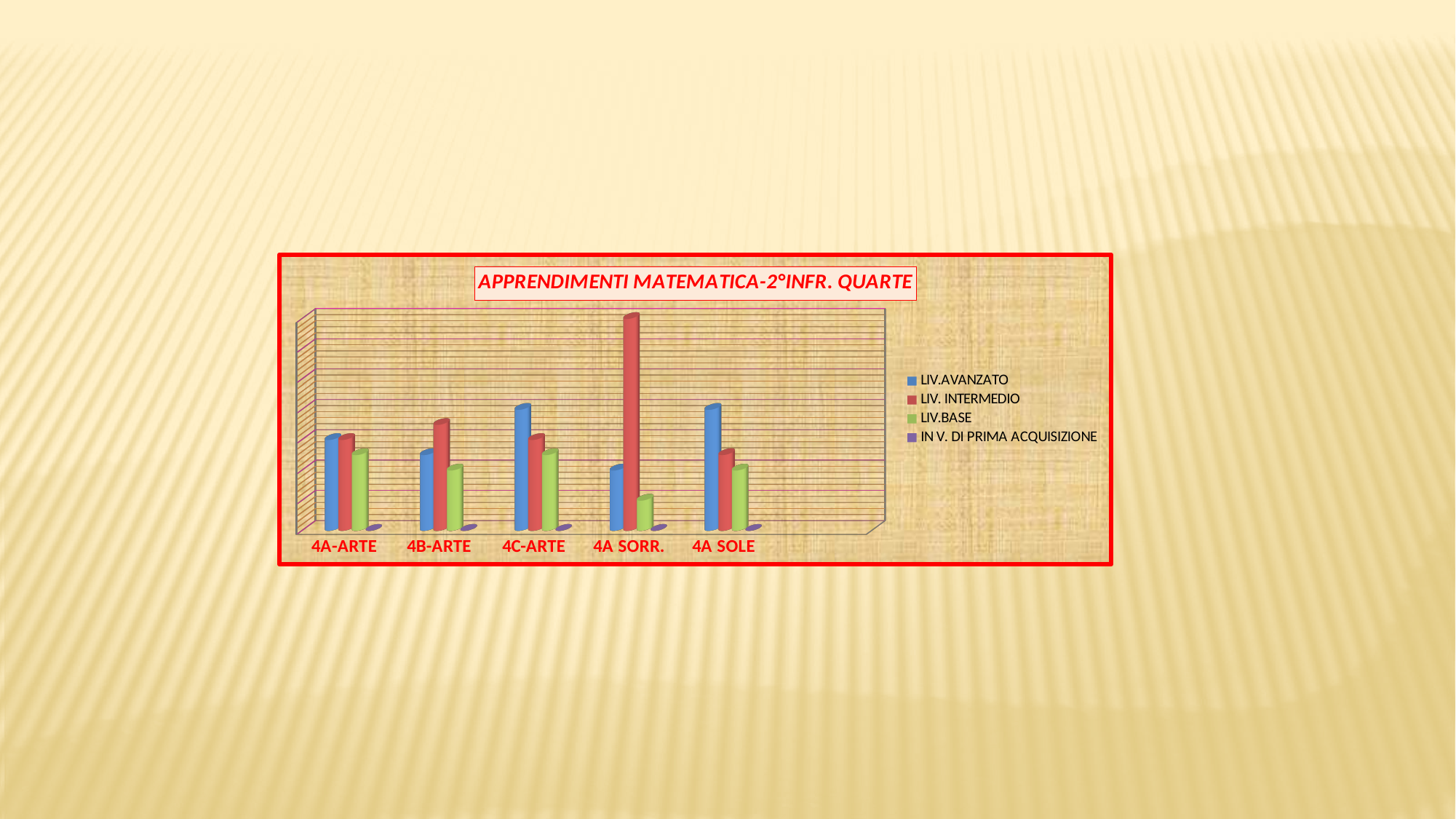
For 4B-ARTE, which is larger: LIV.AVANZATO or LIV. INTERMEDIO? LIV. INTERMEDIO Which class has the highest LIV. INTERMEDIO bar? 4A SORR. What kind of chart is shown on the slide? bar chart For 4A SORR., which is larger: LIV.AVANZATO or LIV. INTERMEDIO? LIV. INTERMEDIO How many series does the chart legend list? 4 Which class has the lowest LIV. INTERMEDIO bar? 4A SOLE Which class has the lowest LIV.BASE bar? 4A SORR. Which series is shown in green in the chart? LIV.BASE For 4C-ARTE, which is larger: LIV.AVANZATO or LIV. INTERMEDIO? LIV.AVANZATO How many classes (categories) are shown on the x axis of the chart? 5 What is the title of the chart? APPRENDIMENTI MATEMATICA-2°INFR. QUARTE